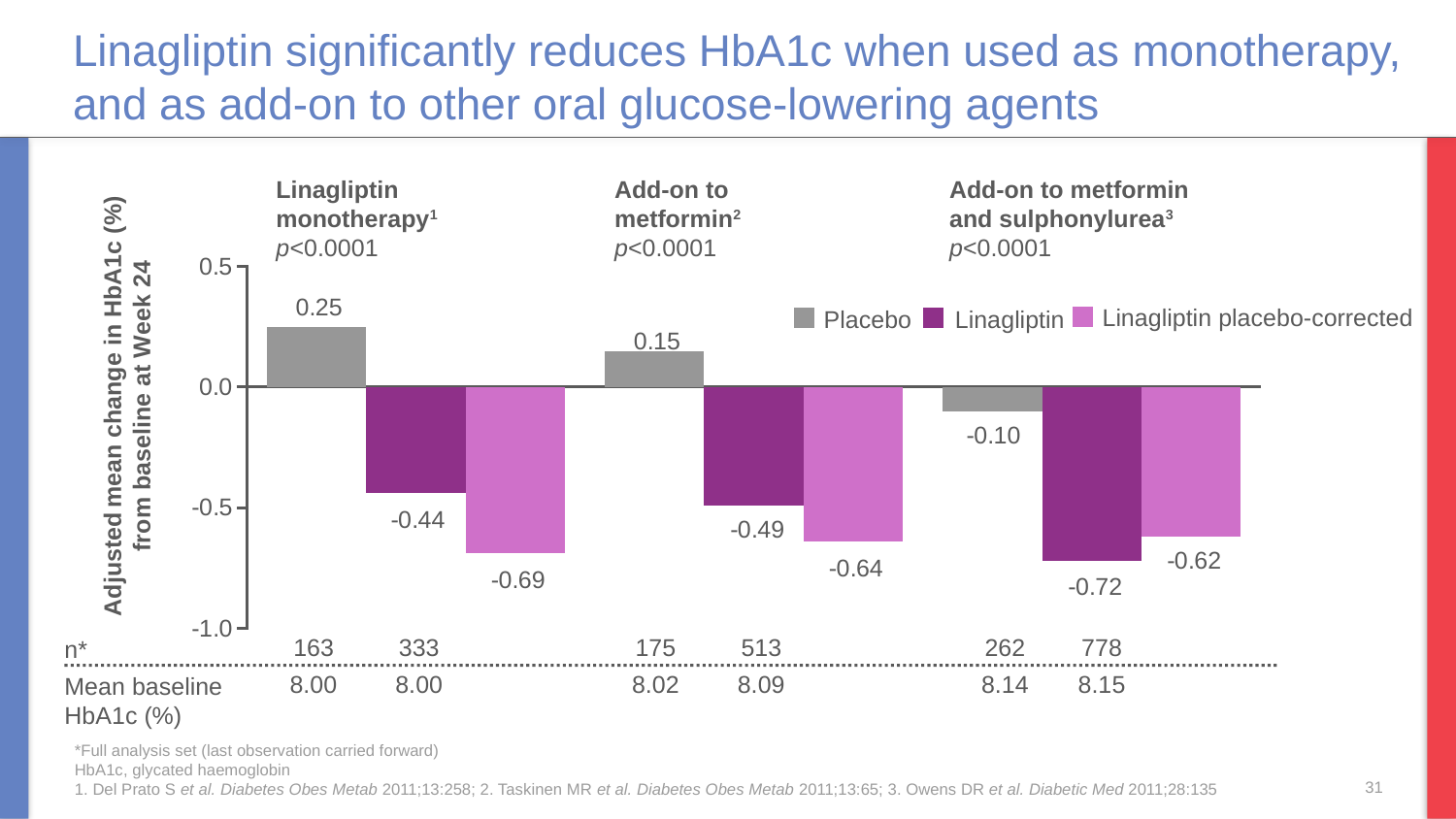
Is the Linagliptin placebo-corrected value for Linagliptin monotherapy greater or less than the Linagliptin placebo-corrected value for Add-on to metformin? less What kind of chart is shown on the slide? bar chart What is the placebo value for Linagliptin monotherapy? 0.25 What is the difference between the Linagliptin placebo-corrected value and the Linagliptin value for Linagliptin monotherapy? 0.25 What is the Linagliptin placebo-corrected value for Add-on to metformin and sulphonylurea? -0.62 How many treatment groups are shown on the chart? 3 How many series does the legend list? 3 What is the placebo value for Add-on to metformin and sulphonylurea? -0.10 Which treatment group has the lowest Linagliptin value? Add-on to metformin and sulphonylurea What is the label of the y axis? Adjusted mean change in HbA1c (%) from baseline at Week 24 What is the Linagliptin value for Add-on to metformin? -0.49 Which treatment group has the highest placebo value? Linagliptin monotherapy